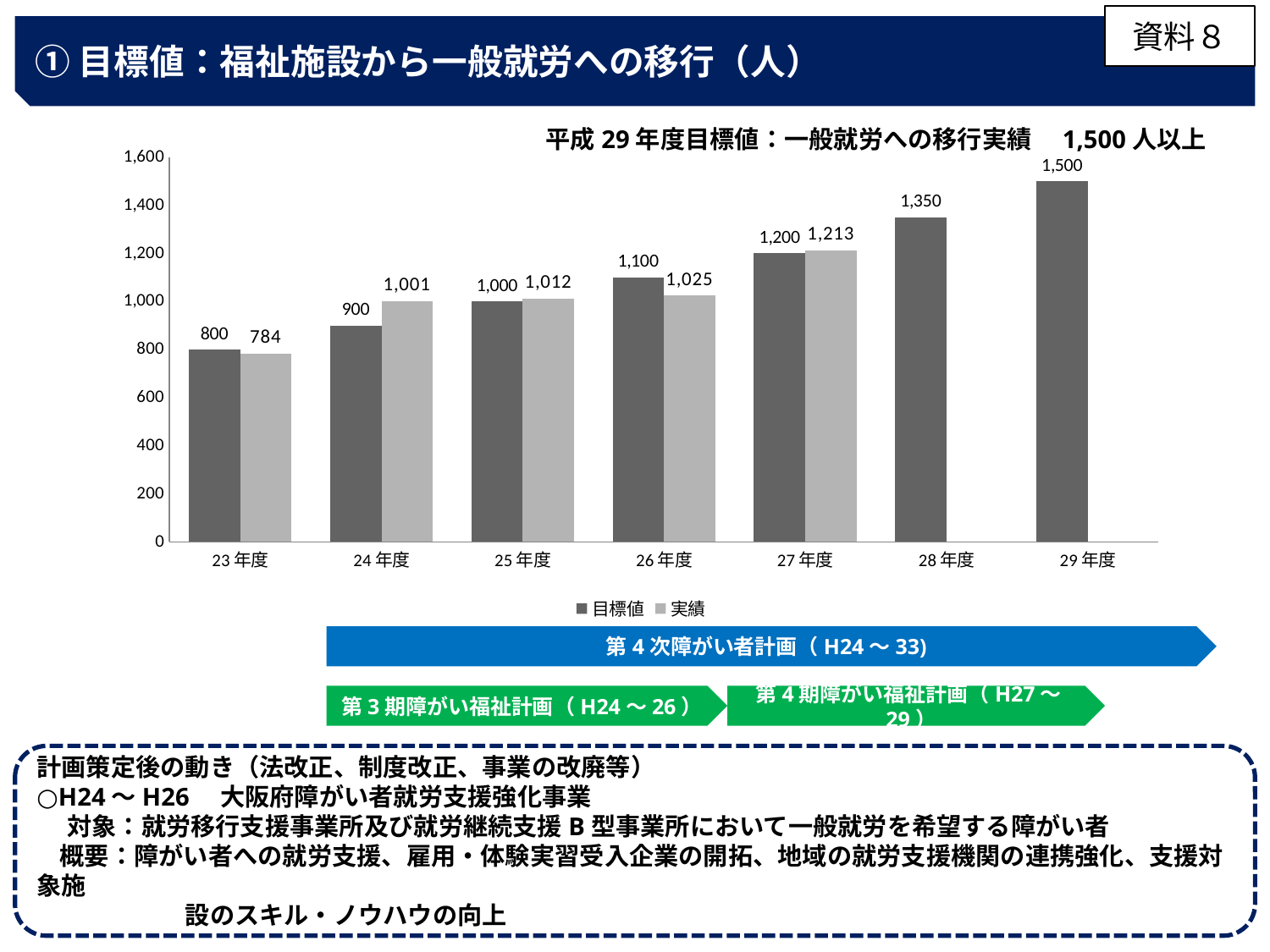
How many years (categories) are shown on the x axis? 7 What kind of chart is shown on the slide? Bar chart What is the 実績 value for 27年度? 1,213 Which year has the lowest 実績 value? 23年度 Do the 目標値 values rise or fall from 23年度 to 29年度? Rise How many series does the legend list? 2 Which is larger for 26年度, the 目標値 or the 実績? 目標値 Which series is shown in the darker grey bars? 目標値 Which year has the highest 目標値? 29年度 What is the 目標値 for 25年度? 1,000 What is the difference between the 目標値 and 実績 for 24年度? 101 What is the 実績 value for 23年度? 784